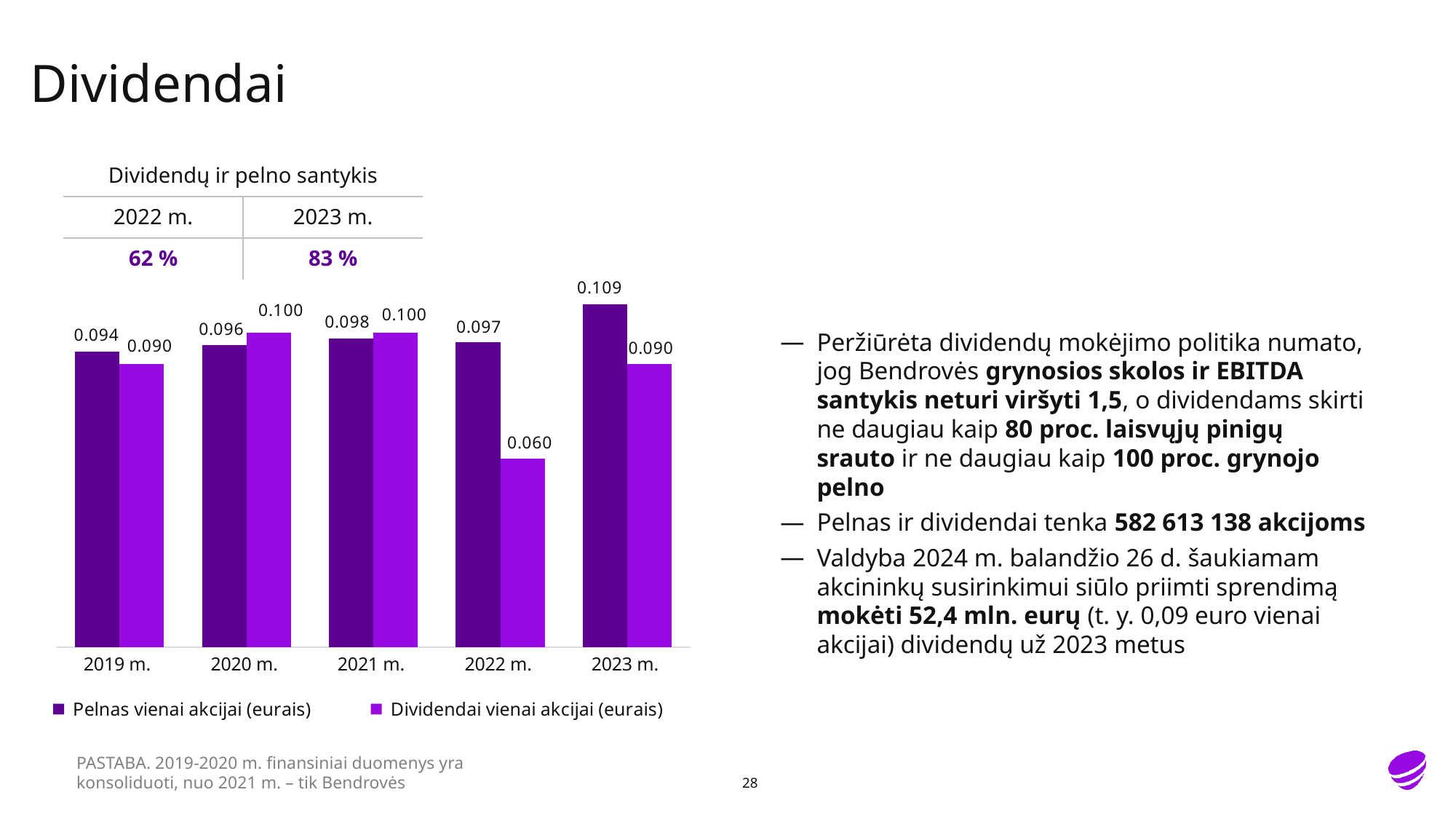
In which year is Pelnas vienai akcijai (eurais) the highest? 2023 m. In 2020 m., which is larger: Pelnas vienai akcijai or Dividendai vienai akcijai? Dividendai vienai akcijai (eurais) What type of chart is shown on the slide? Bar chart Does Dividendai vienai akcijai (eurais) rise or fall from 2021 m. to 2022 m.? Fall How many years are shown on the x axis of the chart? 5 What is the value of Dividendai vienai akcijai (eurais) for 2022 m.? 0.060 How many series does the chart legend list? 2 What is the difference between Pelnas vienai akcijai and Dividendai vienai akcijai in 2023 m.? 0.019 What is the value of Dividendai vienai akcijai (eurais) for 2021 m.? 0.100 In which year is Dividendai vienai akcijai (eurais) the lowest? 2022 m. What is the value of Pelnas vienai akcijai (eurais) for 2023 m.? 0.109 What is the difference between Pelnas vienai akcijai and Dividendai vienai akcijai in 2022 m.? 0.037